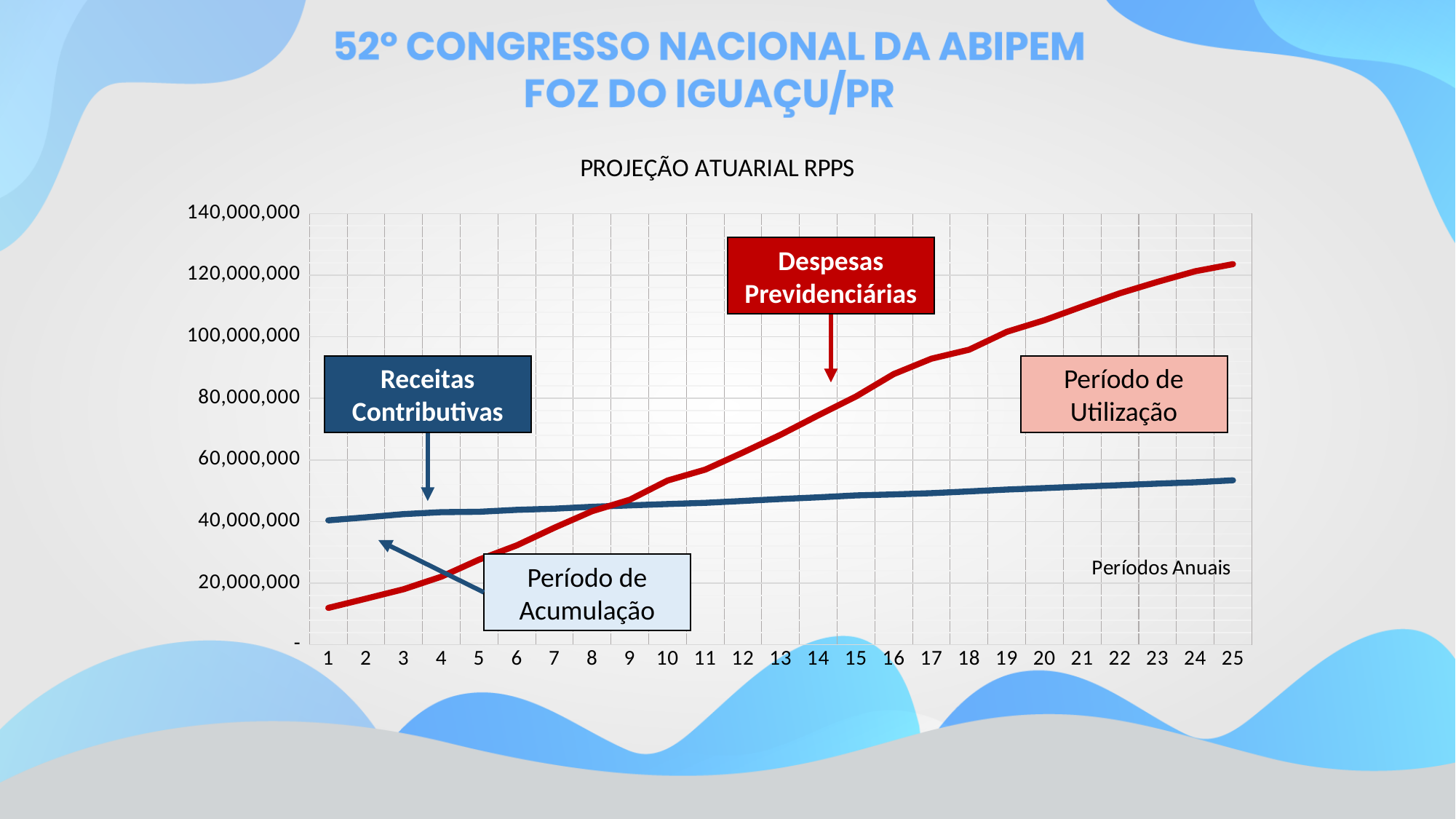
In period 1, which series has the larger value, Receitas Contributivas or Despesas Previdenciárias? Receitas Contributivas How many annual periods are plotted along the x axis? 25 Do the Despesas Previdenciárias values rise or fall from period 1 to period 25? rise How many data series are plotted on the chart? 2 Do the Receitas Contributivas values rise or fall from period 1 to period 25? rise Is the value of Despesas Previdenciárias in period 16 greater or less than 80,000,000? greater What kind of chart is shown on the slide? line chart What colour is the Despesas Previdenciárias line? red What is the title of the chart? PROJEÇÃO ATUARIAL RPPS Is the value of Receitas Contributivas in period 25 greater or less than 60,000,000? less In period 25, which series has the larger value, Receitas Contributivas or Despesas Previdenciárias? Despesas Previdenciárias Is the value of Despesas Previdenciárias in period 1 greater or less than 20,000,000? less